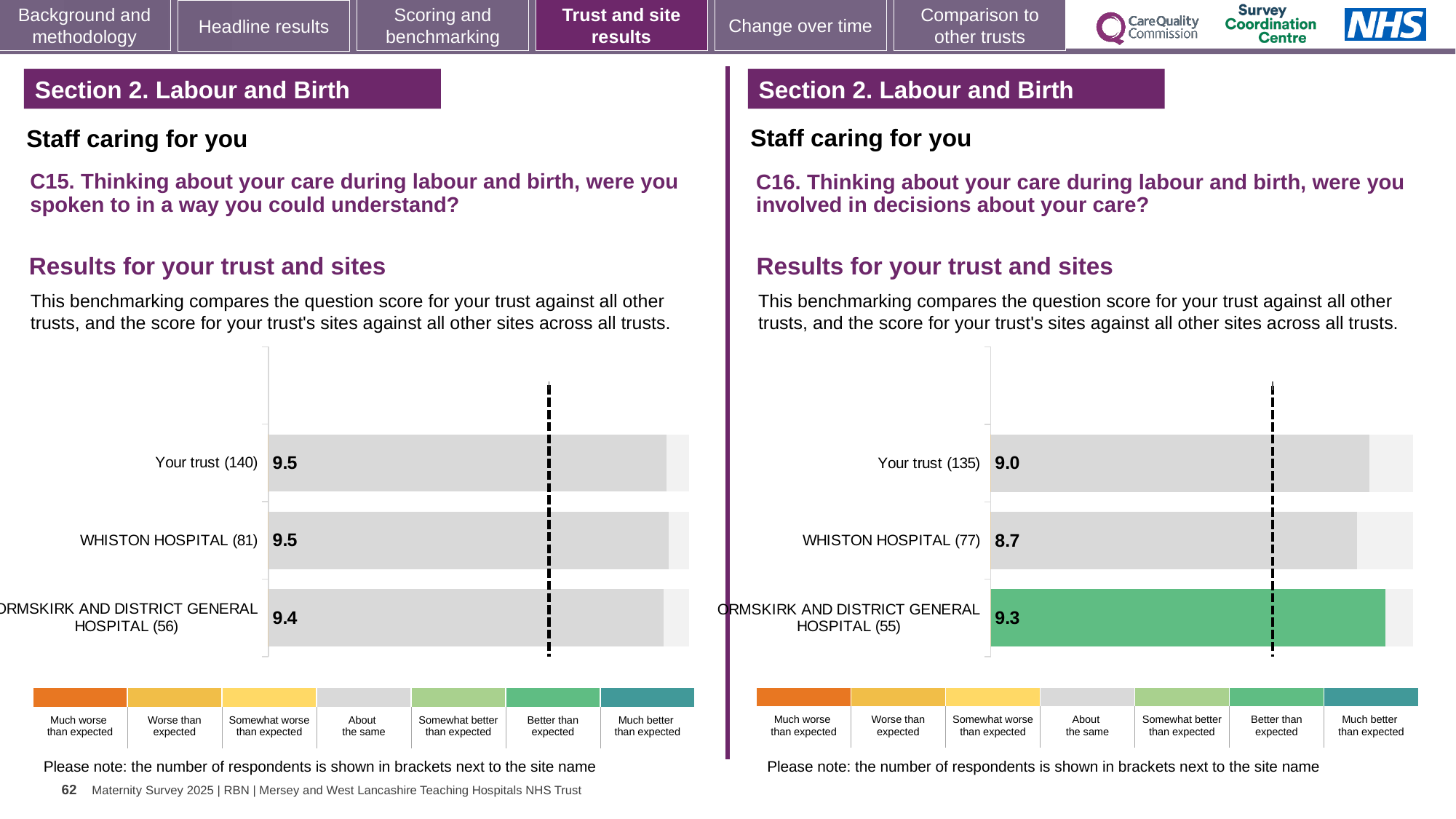
What type of chart is used in the C16 chart on the right? Bar chart In the C16 chart on the right, what is the score for Your trust (135)? 9.0 In the C16 chart on the right, which site or trust has the lowest score? WHISTON HOSPITAL (77) In the C15 chart on the left, what is the score for Your trust (140)? 9.5 In the C16 chart on the right, which bar is coloured green rather than grey? ORMSKIRK AND DISTRICT GENERAL HOSPITAL (55) In the C16 chart on the right, which site or trust has the highest score? ORMSKIRK AND DISTRICT GENERAL HOSPITAL (55) In the C15 chart on the left, how many bars are plotted? 3 In the C15 chart on the left, what is the score for WHISTON HOSPITAL (81)? 9.5 In the C16 chart on the right, what is the score for WHISTON HOSPITAL (77)? 8.7 In the C16 chart on the right, what is the score for ORMSKIRK AND DISTRICT GENERAL HOSPITAL (55)? 9.3 In the C15 chart on the left, what is the score for ORMSKIRK AND DISTRICT GENERAL HOSPITAL (56)? 9.4 In the C16 chart on the right, what is the difference between the scores for ORMSKIRK AND DISTRICT GENERAL HOSPITAL (55) and WHISTON HOSPITAL (77)? 0.6